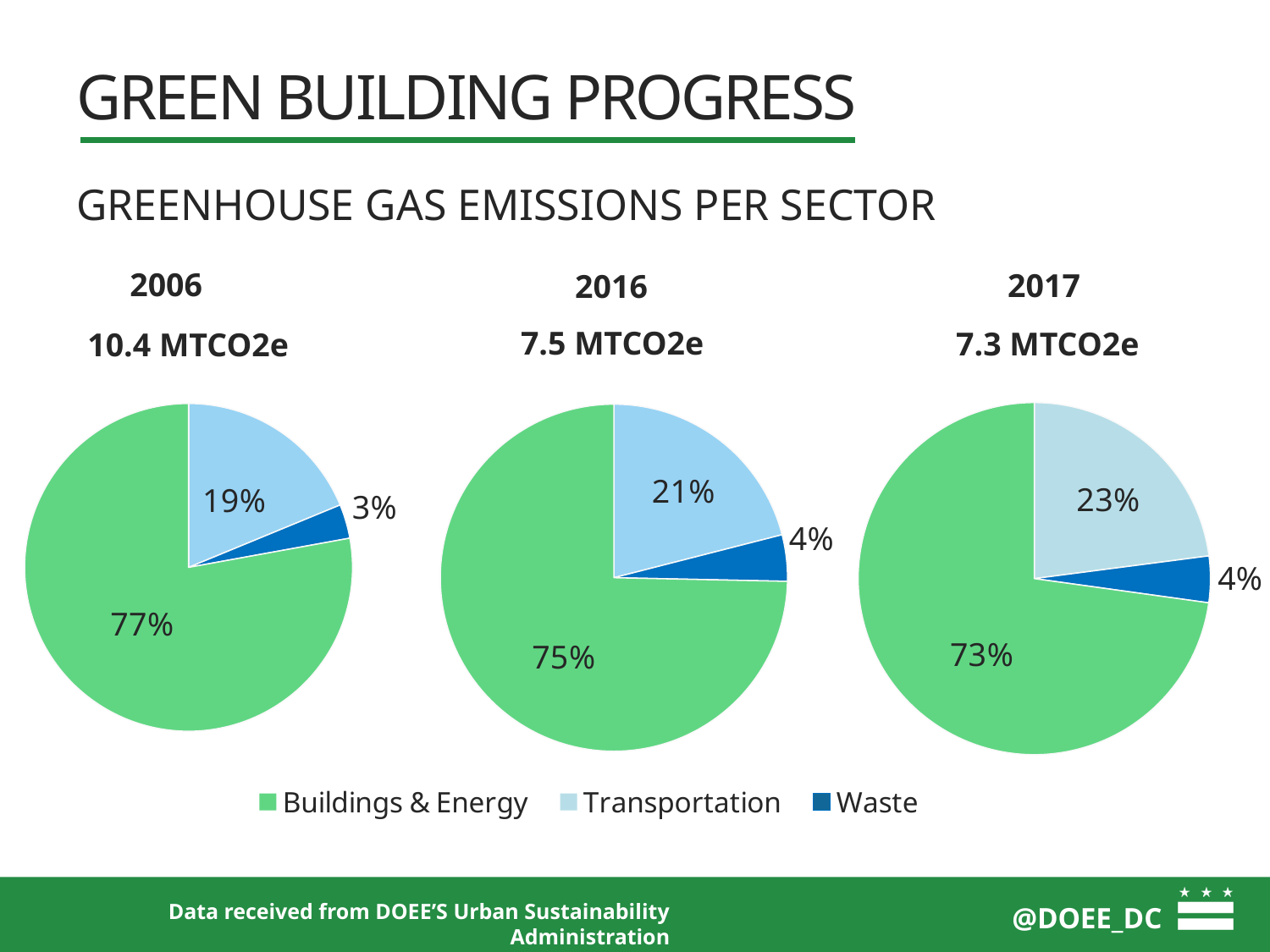
What kind of chart is used to show emissions per sector for each year? Pie chart Is the Transportation share larger in the 2006 chart or the 2017 chart? 2017 In the 2017 pie chart, what share of emissions comes from Waste? 4% In the 2017 pie chart, which sector has the largest share? Buildings & Energy What total emissions value is shown above the 2016 pie chart? 7.5 MTCO2e How many slices does the 2016 pie chart have? 3 Which sector is shown in green in the legend? Buildings & Energy In the 2016 pie chart, what share of emissions comes from Transportation? 21% How many sectors does the legend list? 3 What is the difference between the Buildings & Energy share in the 2006 chart and in the 2017 chart? 4% In the 2006 pie chart, which sector has the smallest share? Waste In the 2006 pie chart, what share of emissions comes from Buildings & Energy? 77%